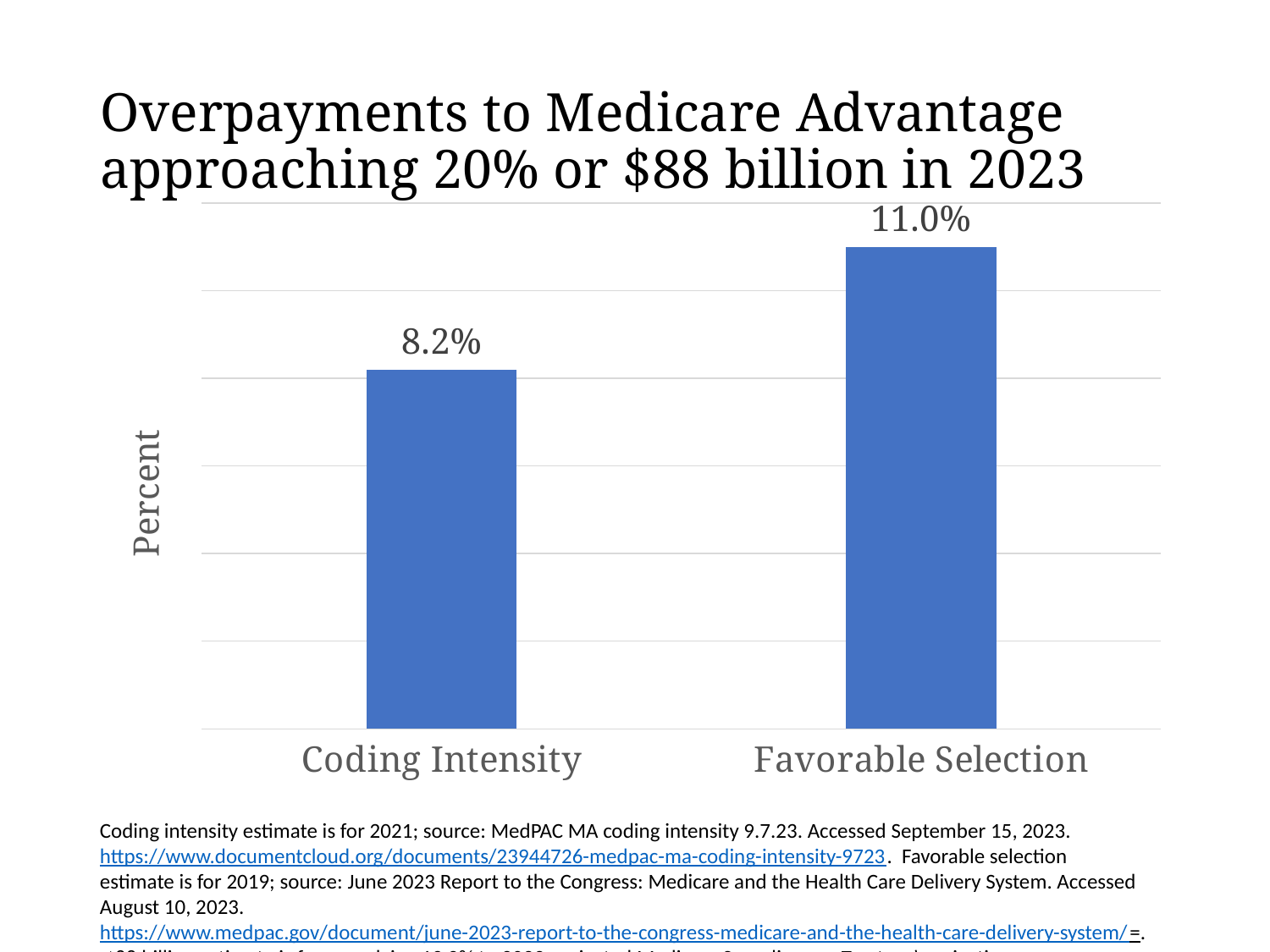
What is the value for Coding Intensity? 8.2% Which category has the highest value? Favorable Selection What is the total of the two values shown in the chart? 19.2% What is the label of the vertical axis? Percent Which category has the lowest value? Coding Intensity What is the value for Favorable Selection? 11.0% What kind of chart is shown on the slide? Bar chart How many categories are shown in the chart? 2 What is the difference between the values for Favorable Selection and Coding Intensity? 2.8% What is the title of the slide containing the chart? Overpayments to Medicare Advantage approaching 20% or $88 billion in 2023 Which is larger, the value for Coding Intensity or the value for Favorable Selection? Favorable Selection